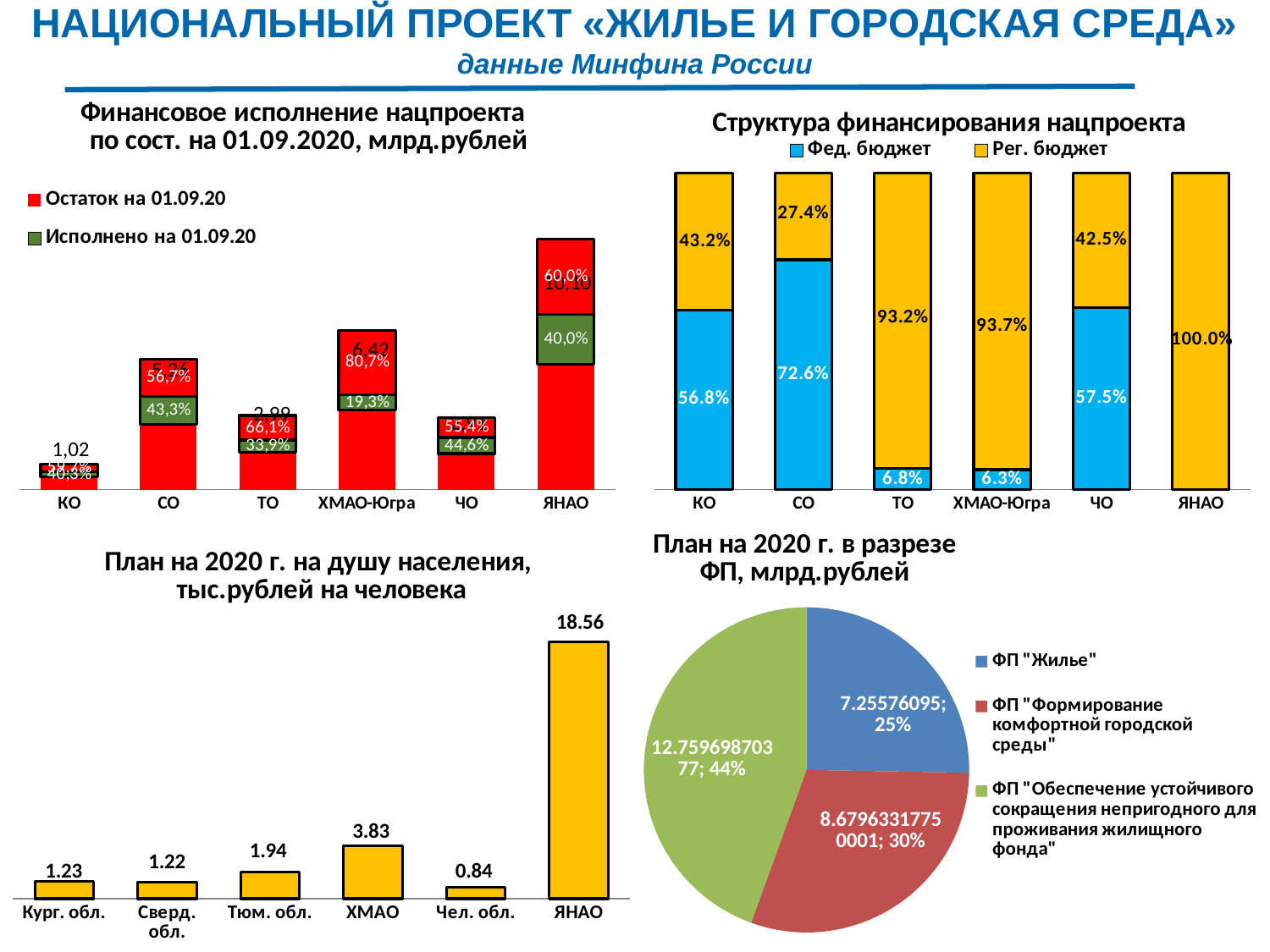
In the chart 'Финансовое исполнение нацпроекта по сост. на 01.09.2020, млрд.рублей', what is the total value for ЯНАО? 10,10 In the chart 'Структура финансирования нацпроекта', which category has the highest Рег. бюджет share? ЯНАО In the chart 'Структура финансирования нацпроекта', how many series does the legend list? 2 In the chart 'Структура финансирования нацпроекта', what is the Рег. бюджет share for ХМАО-Югра? 93.7% In the chart 'План на 2020 г. на душу населения, тыс.рублей на человека', which category has the lowest value? Чел. обл. What kind of chart is 'План на 2020 г. в разрезе ФП, млрд.рублей'? pie chart In the chart 'План на 2020 г. на душу населения, тыс.рублей на человека', how many categories are shown? 6 In the chart 'Структура финансирования нацпроекта', what is the Фед. бюджет share for СО? 72.6% In the chart 'Финансовое исполнение нацпроекта по сост. на 01.09.2020, млрд.рублей', what is the 'Исполнено на 01.09.20' percentage for ХМАО-Югра? 19,3% In the chart 'План на 2020 г. на душу населения, тыс.рублей на человека', what is the value for ЯНАО? 18.56 In the chart 'План на 2020 г. на душу населения, тыс.рублей на человека', what is the difference between the values for ХМАО and Тюм. обл.? 1.89 In the pie chart 'План на 2020 г. в разрезе ФП, млрд.рублей', what share does ФП "Жилье" have? 25%